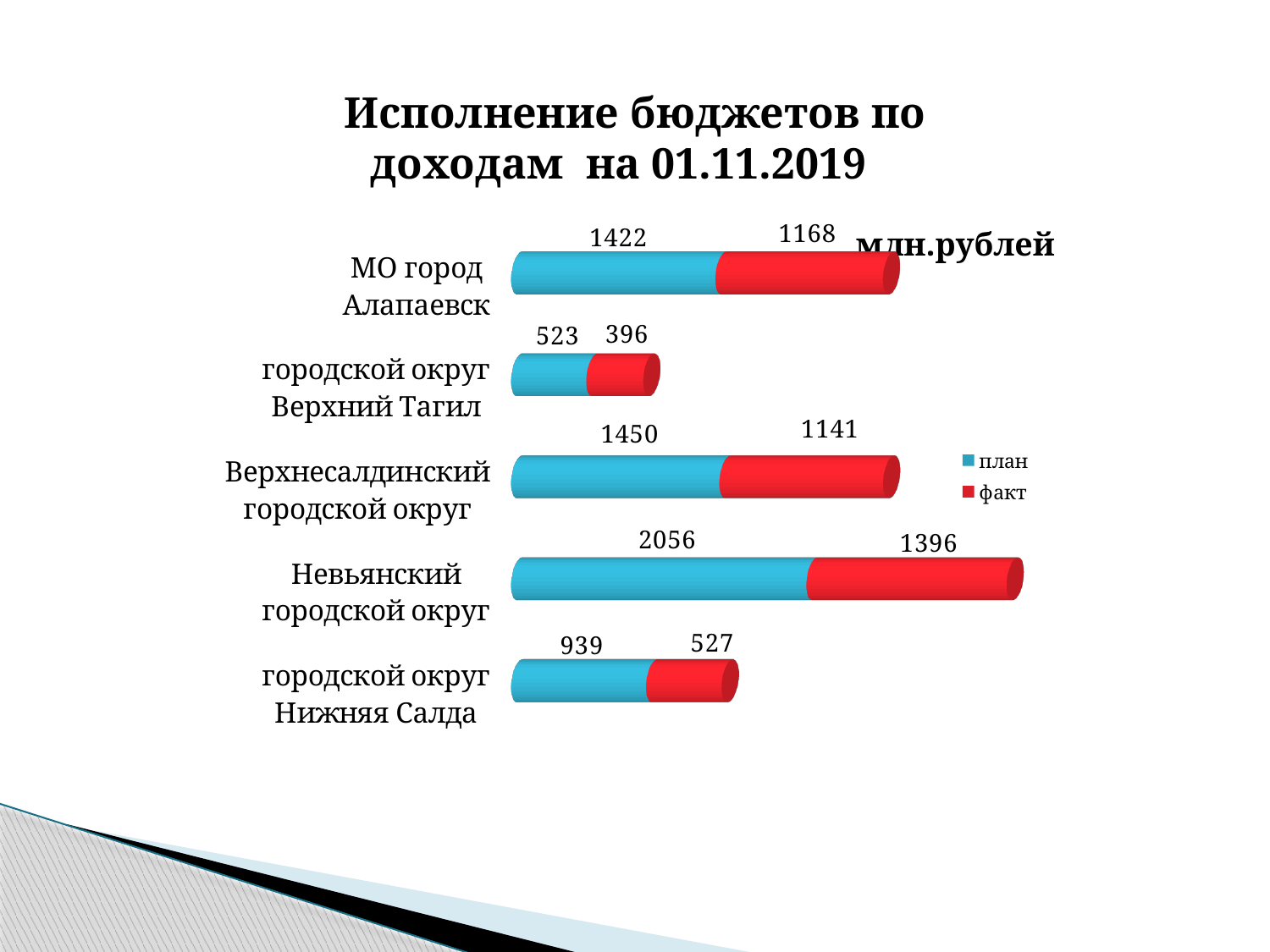
How many series does the legend list? 2 What is the факт value for городской округ Верхний Тагил? 396 What is the план value for городской округ Нижняя Салда? 939 Which is larger, the факт value for МО город Алапаевск or the факт value for Верхнесалдинский городской округ? МО город Алапаевск What kind of chart is shown on the slide? Bar chart What is the факт value for МО город Алапаевск? 1168 What is the total of the stacked bar for городской округ Нижняя Салда? 1466 Which category has the highest план value? Невьянский городской округ How many categories are shown in the chart? 5 Which category has the lowest факт value? городской округ Верхний Тагил What is the difference between план and факт for Верхнесалдинский городской округ? 309 What is the план value for Невьянский городской округ? 2056